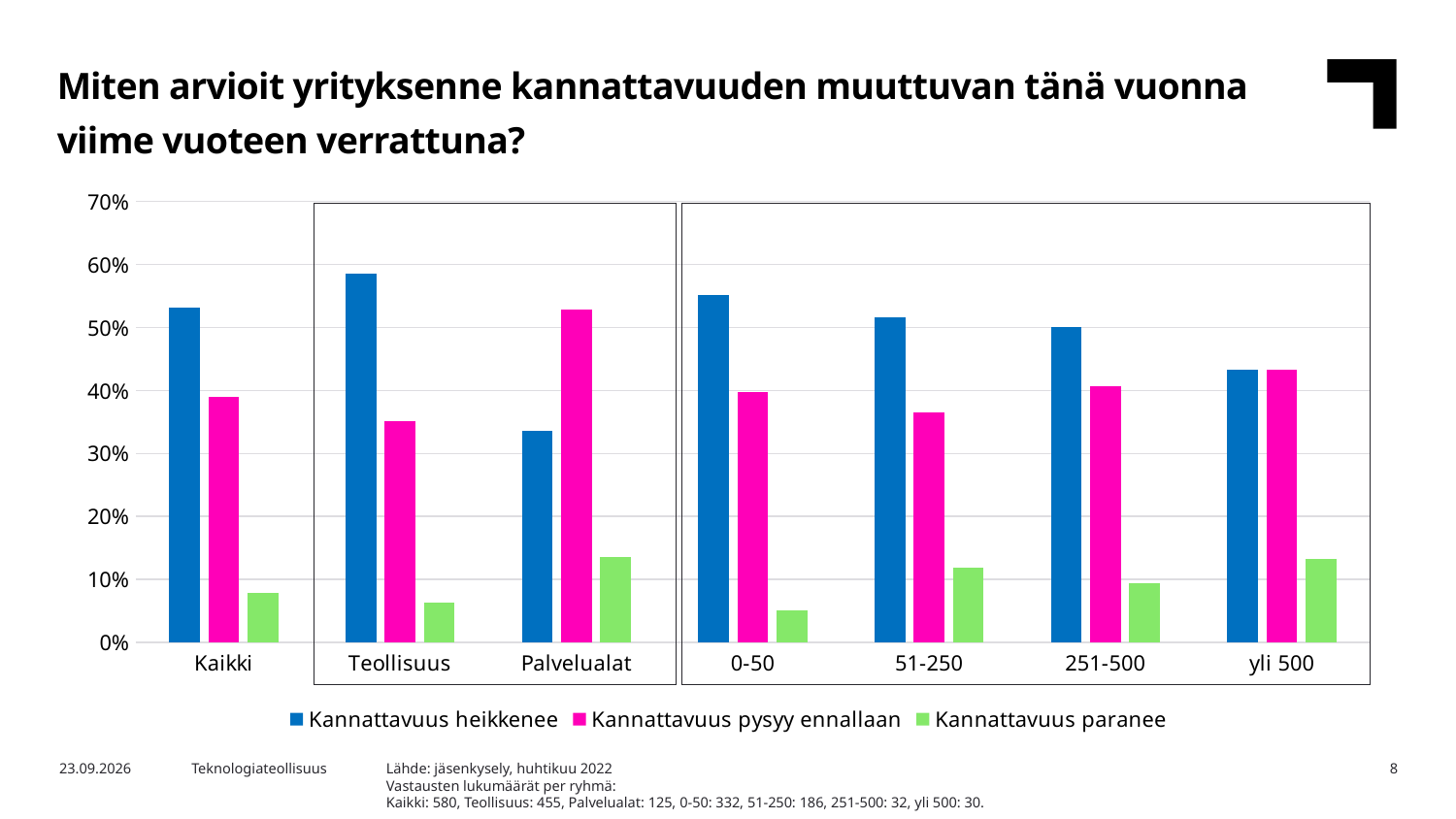
Which category has the lowest value for 'Kannattavuus heikkenee'? Palvelualat What kind of chart is shown on the slide? bar chart Is the value for 'Kannattavuus heikkenee' in Palvelualat greater or less than 40%? less Across the size groups from 0-50 to yli 500, does the value for 'Kannattavuus heikkenee' rise or fall? fall What colour represents 'Kannattavuus pysyy ennallaan' in the legend? magenta (pink) Which category has the highest value for 'Kannattavuus pysyy ennallaan'? Palvelualat Is the value for 'Kannattavuus heikkenee' in Teollisuus greater or less than 50%? greater How many series does the legend list? 3 Is the value for 'Kannattavuus paranee' in Kaikki greater or less than 10%? less Which category has the highest value for 'Kannattavuus heikkenee'? Teollisuus How many categories are shown on the x axis? 7 In the Palvelualat category, which is larger: 'Kannattavuus heikkenee' or 'Kannattavuus pysyy ennallaan'? Kannattavuus pysyy ennallaan